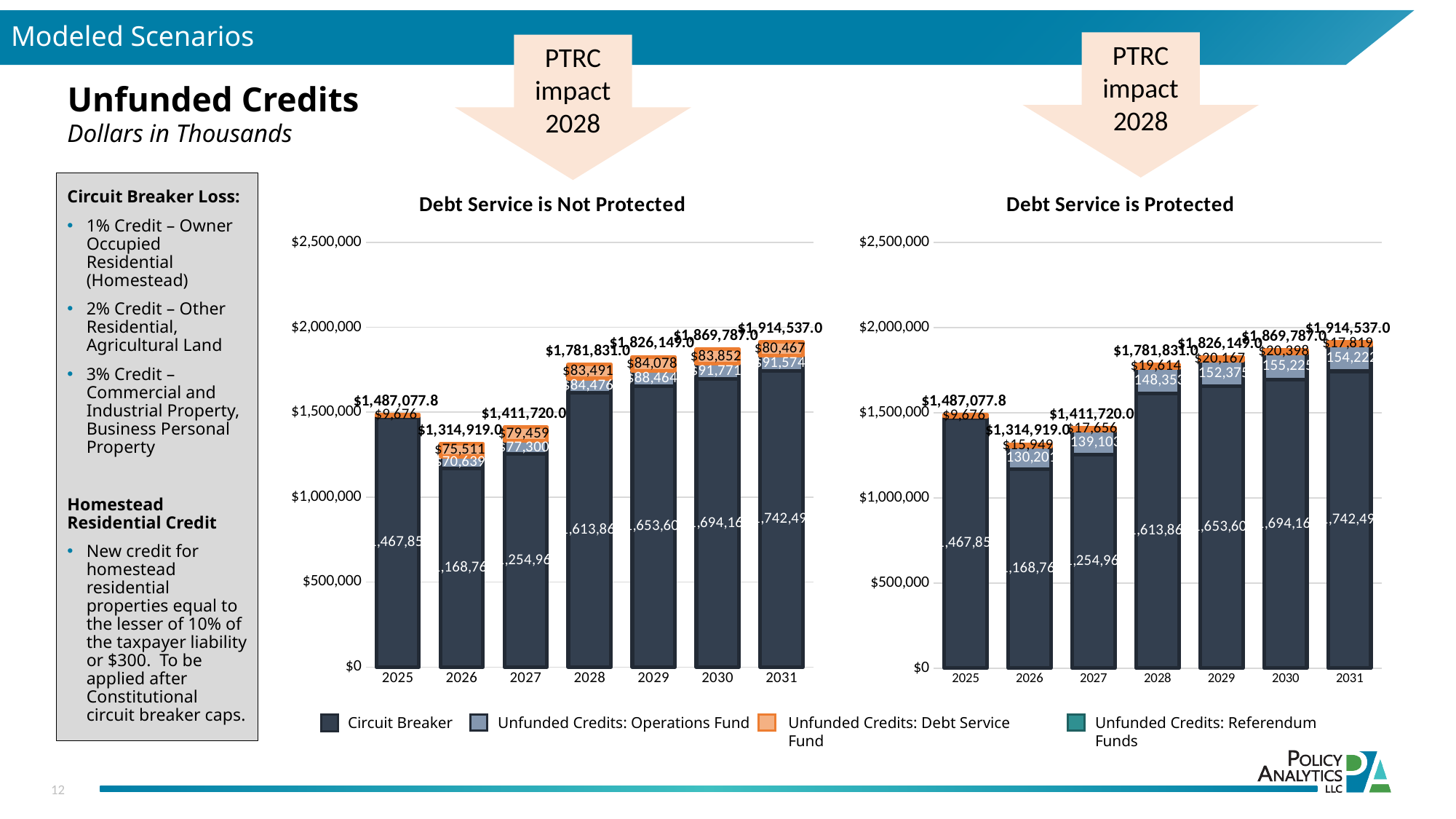
How many series does the shared legend list for the charts? 4 What kind of chart is 'Debt Service is Protected'? Stacked bar chart How many years are shown on the x axis of the 'Debt Service is Not Protected' chart? 7 In the 'Debt Service is Not Protected' chart, what is the total labeled above the 2031 bar? $1,914,537.0 In the 'Debt Service is Protected' chart, which year has the highest total? 2031 Which is larger: the 2028 Unfunded Credits: Debt Service Fund value in the 'Debt Service is Not Protected' chart or in the 'Debt Service is Protected' chart? Debt Service is Not Protected In the 'Debt Service is Not Protected' chart, which year has the lowest total? 2026 In the 'Debt Service is Protected' chart, what is the Unfunded Credits: Debt Service Fund value for 2030? $20,398 In the 'Debt Service is Not Protected' chart, is the 2026 total greater or less than $1,500,000? less In the 'Debt Service is Protected' chart, what is the difference between the 2031 total and the 2030 total? $44,750.0 In the 'Debt Service is Protected' chart, do the bar totals rise or fall from 2028 to 2031? Rise In the 'Debt Service is Not Protected' chart, what is the Unfunded Credits: Debt Service Fund value for 2029? $84,078